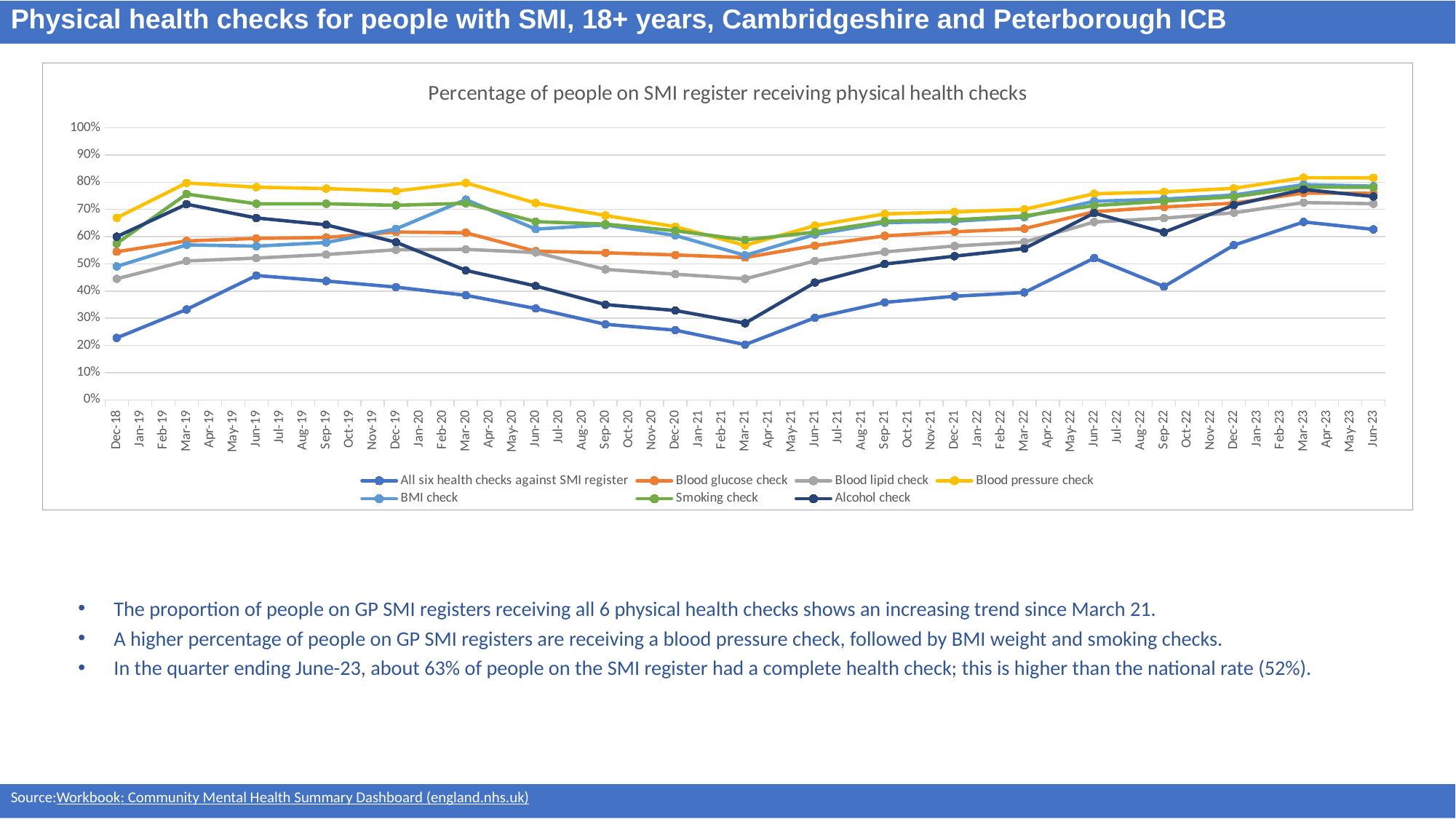
Which series has the lowest values across the whole period? All six health checks against SMI register Which series has the highest values across most of the period? Blood pressure check Is the value for 'Alcohol check' at Mar-21 greater or less than 40%? less What kind of chart is shown on the slide? Line chart Is the value for 'All six health checks against SMI register' at Mar-21 greater or less than 30%? less At which date does the 'All six health checks against SMI register' series reach its lowest point? Mar-21 Which is larger for 'All six health checks against SMI register': the value at Dec-18 or the value at Jun-23? Jun-23 What is the title of the chart? Percentage of people on SMI register receiving physical health checks How many series does the legend list? 7 Is the value for 'Blood pressure check' at Mar-19 greater or less than 70%? greater From Mar-21 to Jun-23, does the 'All six health checks against SMI register' series generally rise or fall? Rise Which series is plotted in yellow? Blood pressure check